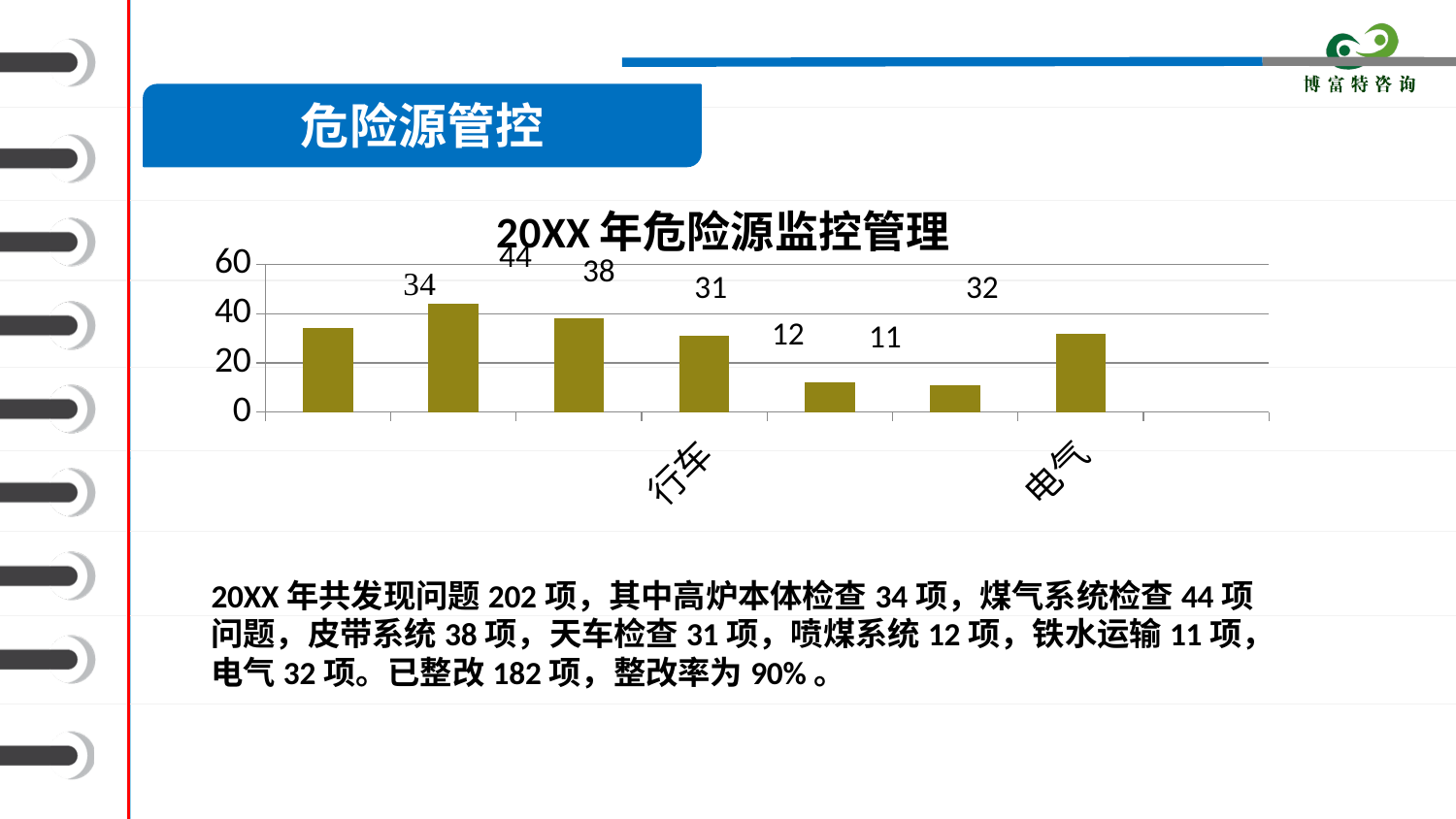
How many bars are plotted in the chart? 7 What is the value for 电气 in the chart? 32 What is the value of the first (leftmost) bar in the chart? 34 Is the value for 行车 greater or less than 20? greater What is the difference between the highest and lowest bar values in the chart? 33 Which has the larger value, 电气 or 行车? 电气 What kind of chart is shown on the slide? bar chart What is the lowest value shown by any bar in the chart? 11 What is the value for 行车 in the chart? 31 What is the difference between the values for 电气 and 行车? 1 What is the highest value shown by any bar in the chart? 44 What is the title of the chart? 20XX年危险源监控管理